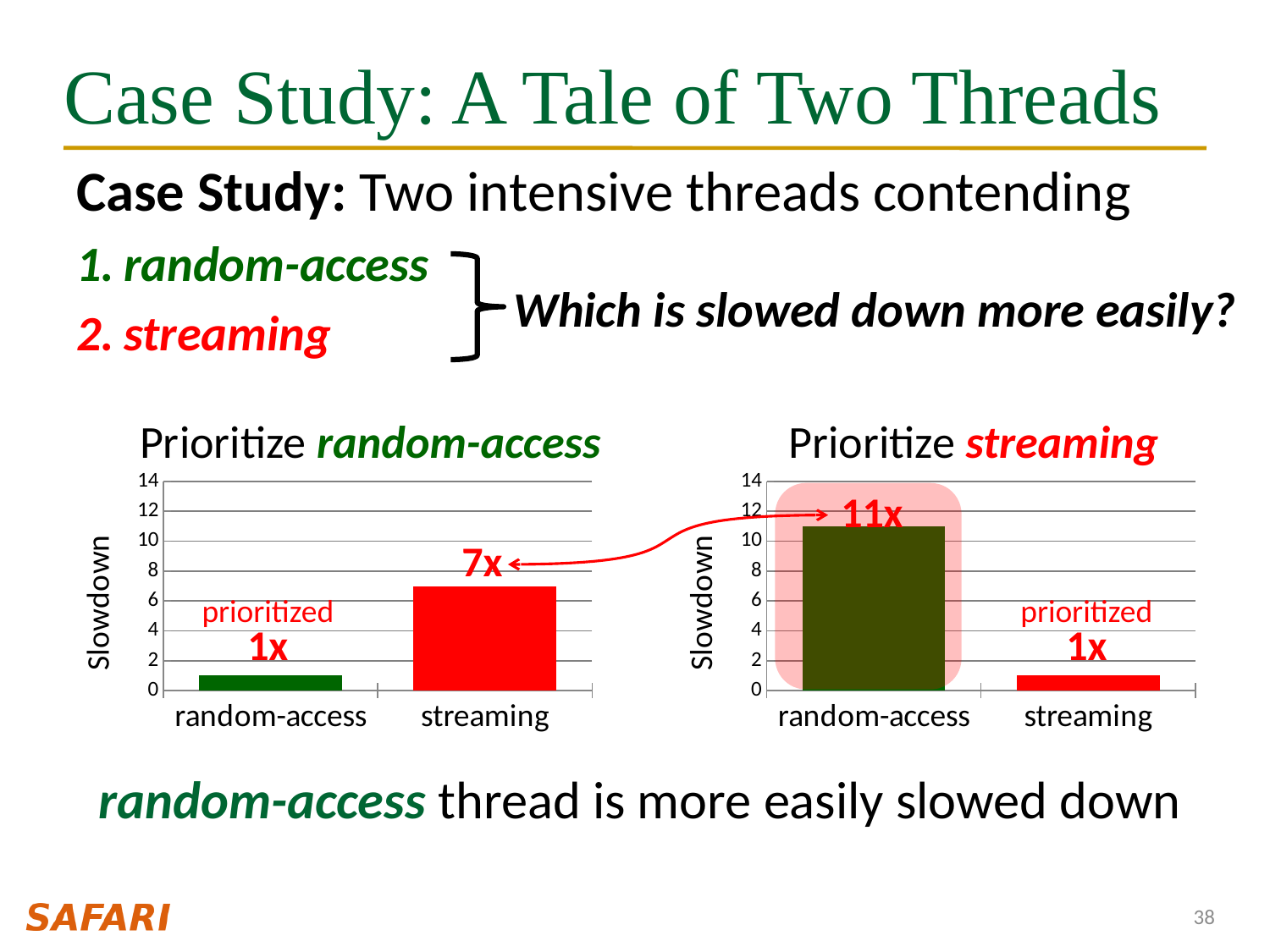
In the 'Prioritize random-access' chart, what is the slowdown for the random-access thread? 1x In the 'Prioritize streaming' chart, what is the difference in slowdown between the random-access and streaming threads? 10x What is the y-axis label of the 'Prioritize random-access' chart? Slowdown How many categories are shown on the x axis of the 'Prioritize random-access' chart? 2 In the 'Prioritize streaming' chart, what is the slowdown for the random-access thread? 11x What kind of chart is the 'Prioritize streaming' chart? bar chart In the 'Prioritize streaming' chart, what is the slowdown for the streaming thread? 1x In the 'Prioritize random-access' chart, what is the slowdown for the streaming thread? 7x Is the slowdown of the random-access thread in the 'Prioritize streaming' chart greater or less than 10? greater In the 'Prioritize random-access' chart, what is the difference in slowdown between the streaming and random-access threads? 6x In the 'Prioritize random-access' chart, which thread has the higher slowdown? streaming In the 'Prioritize streaming' chart, which thread has the lower slowdown? streaming